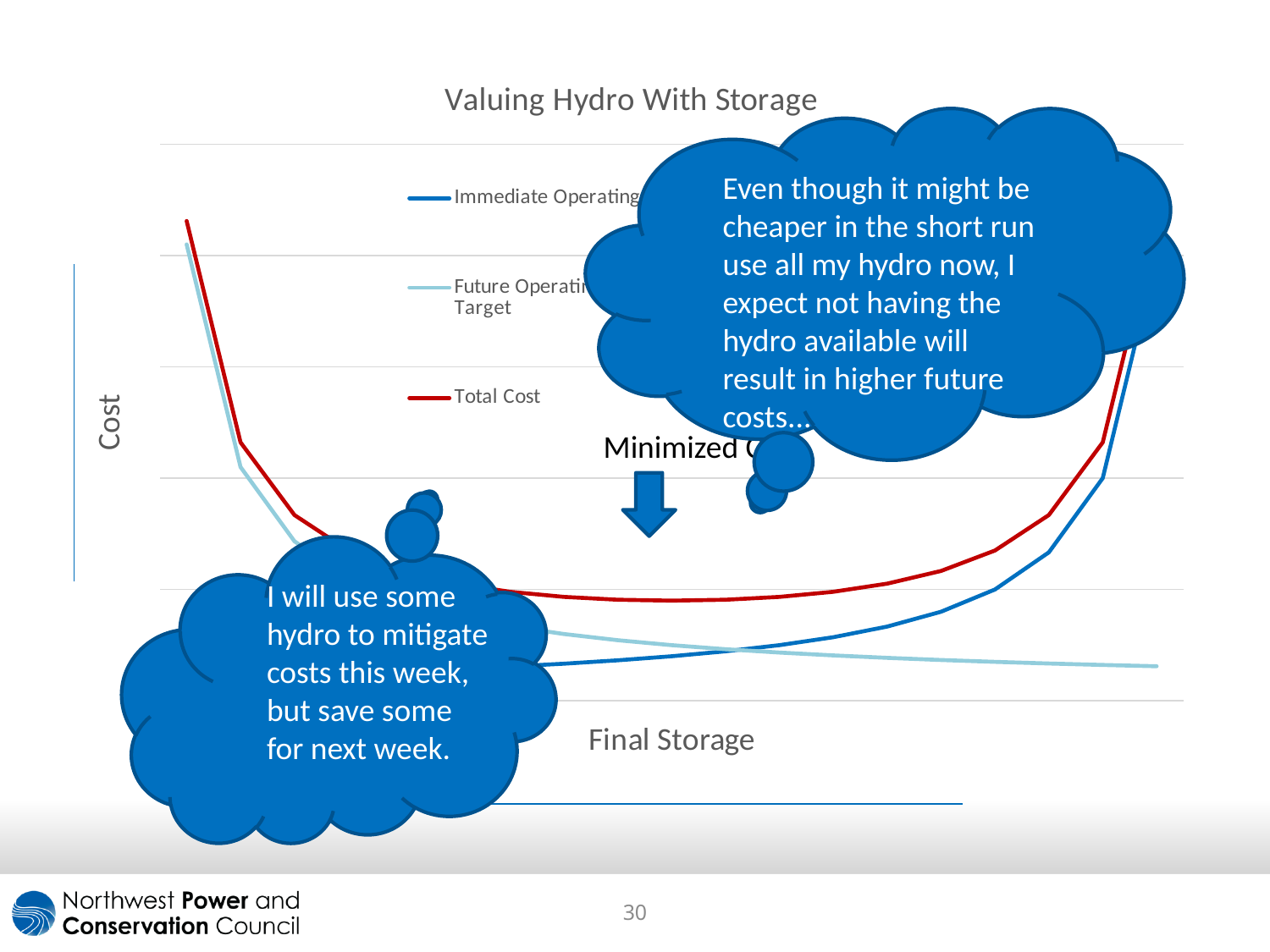
Does the dark blue line (Immediate Operating) rise or fall as Final Storage increases? Rise At the far right of the chart, which line is higher: Total Cost or the light blue Future Operating Target line? Total Cost Does the light blue line (Future Operating Target) rise or fall as Final Storage increases? Fall Does the Total Cost line fall and then rise, or rise and then fall, as Final Storage increases? Fall and then rise What kind of chart is shown on the slide? Line chart What is the title of the chart? Valuing Hydro With Storage What colour is the Total Cost line in the chart? Red How many series does the chart's legend list? 3 At the far left of the chart, which line is higher: Total Cost or the dark blue Immediate Operating line? Total Cost What is the label on the chart's horizontal axis? Final Storage